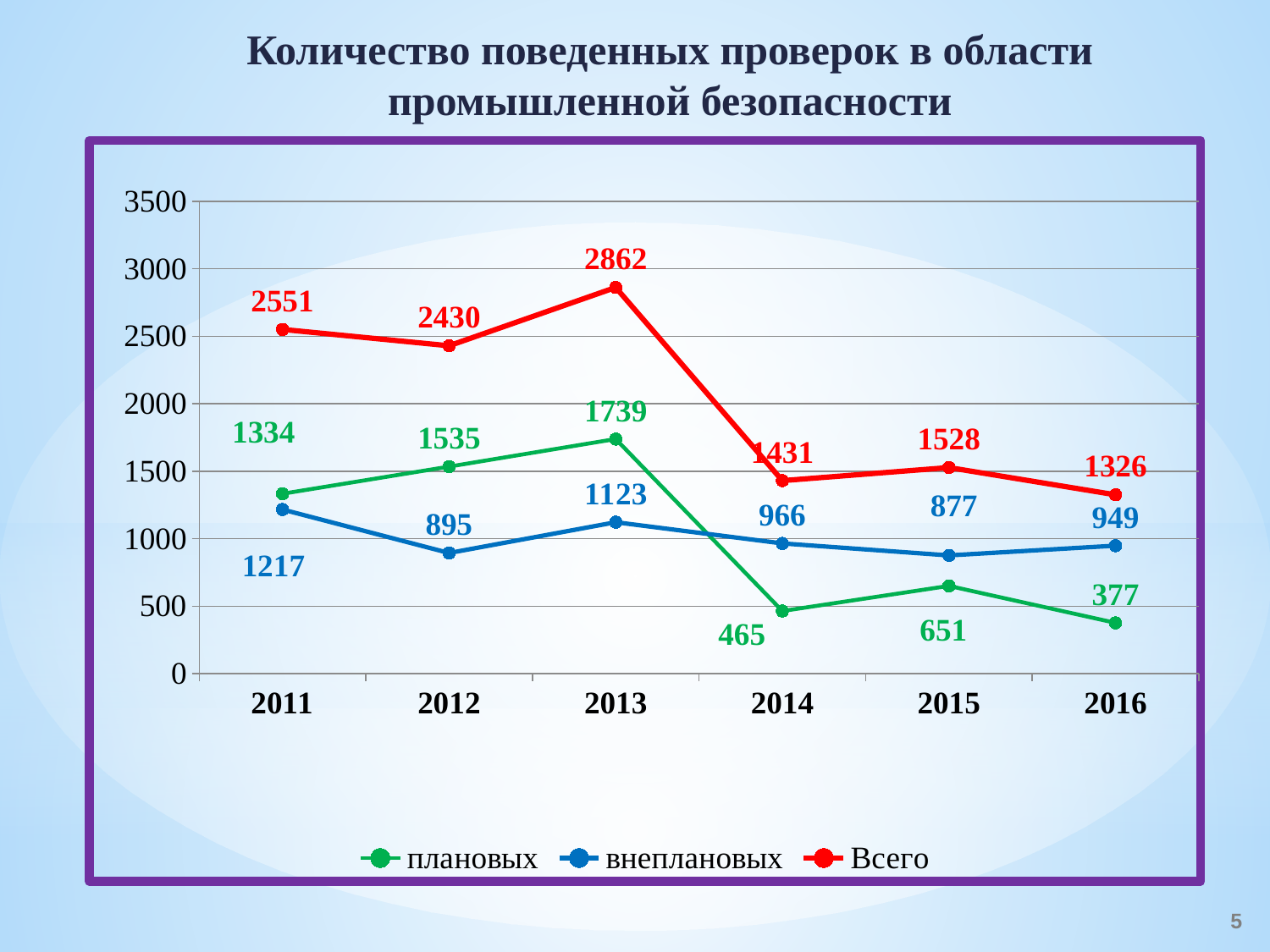
What colour is the line for внеплановых? blue What is the value of плановых in 2016? 377 In which year is плановых lowest? 2016 What is the difference between Всего in 2013 and Всего in 2014? 1431 Which is larger in 2014: плановых or внеплановых? внеплановых How many years are shown on the x axis? 6 What is the value of внеплановых in 2012? 895 What type of chart is shown on the slide? line chart In which year is Всего highest? 2013 Does the Всего series rise or fall from 2013 to 2016? fall How many series does the legend list? 3 What is the value of Всего in 2013? 2862